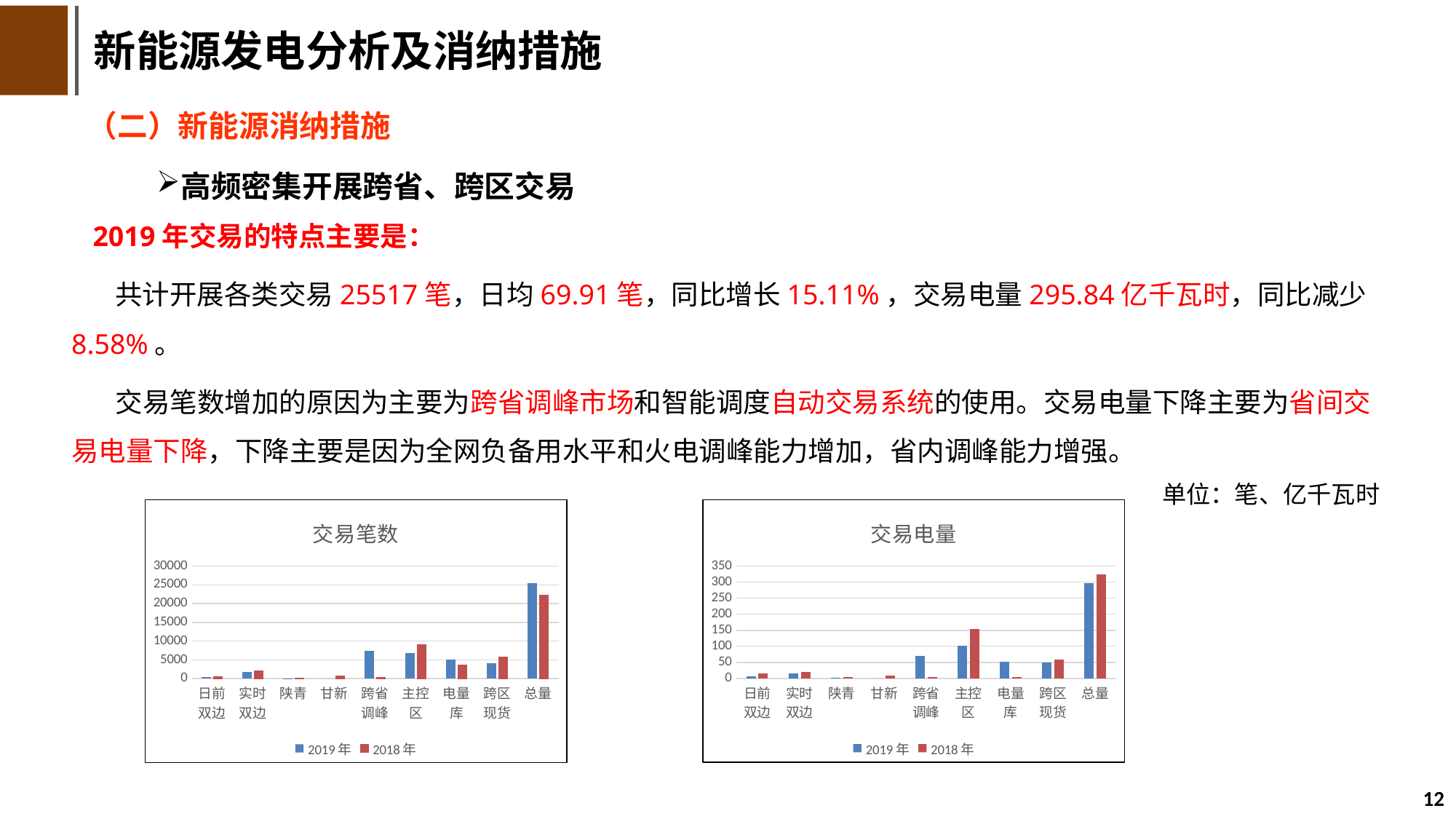
In the 交易笔数 chart, is the 2019年 value for 跨省调峰 greater or less than 5000? greater How many categories are shown on the x axis of the 交易电量 chart? 9 How many series does the legend of the 交易笔数 chart list? 2 In the 交易笔数 chart, is the 2019年 value for 总量 greater or less than 20000? greater In the 交易电量 chart, which category has the highest value for 2018年? 总量 In the 交易电量 chart, is the 2018年 value for 主控区 greater or less than 100? greater In the 交易笔数 chart, which is larger for 主控区: the 2019年 value or the 2018年 value? 2018年 What kind of chart is the 交易笔数 chart? bar chart In the 交易笔数 chart, which category has the highest value for 2019年? 总量 What are the two legend entries in the 交易电量 chart? 2019年 and 2018年 In the 交易电量 chart, which is larger for 跨省调峰: the 2019年 value or the 2018年 value? 2019年